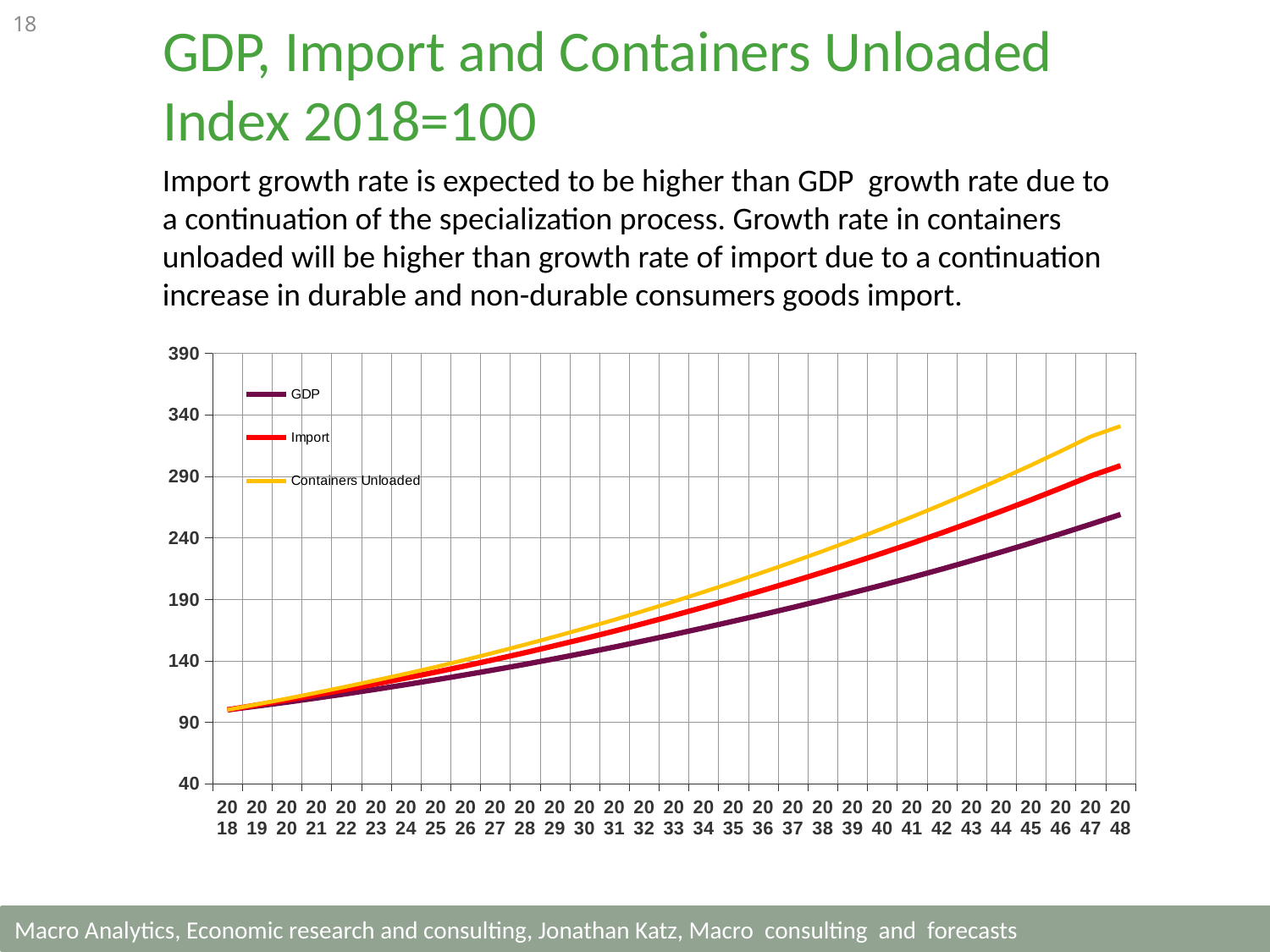
What is the first year shown on the x axis of the chart? 2018 Is the value for GDP in 2048 greater or less than 290? less What kind of chart is shown on the slide? line chart In 2040, which is larger, the Import value or the GDP value? Import Which series has the highest value in 2048? Containers Unloaded Is the value for Containers Unloaded in 2048 greater or less than 290? greater Which series are listed in the chart legend? GDP, Import, Containers Unloaded How many years are plotted along the x axis of the chart? 31 How many series does the chart legend list? 3 Is the value for Import in 2048 greater or less than 340? less Do the values of the Containers Unloaded series rise or fall from 2018 to 2048? rise Which series has the lowest value in 2048? GDP